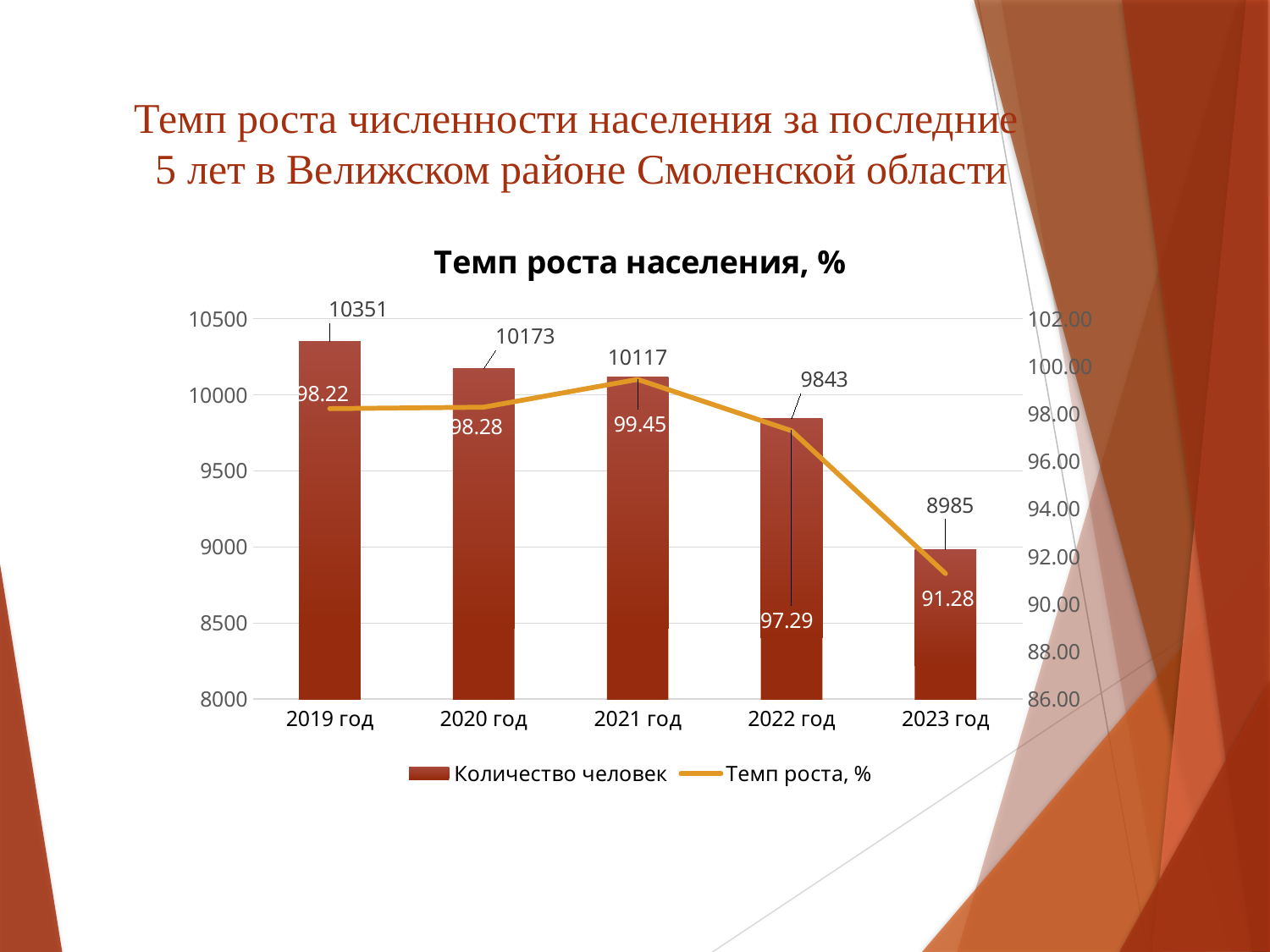
What is the difference in Количество человек between 2019 год and 2023 год? 1366 What is the value of Количество человек for 2019 год? 10351 Does Количество человек rise or fall from 2019 год to 2023 год? fall What is the value of Темп роста, % for 2023 год? 91.28 Is the value of Количество человек for 2022 год greater or less than 10000? less How many years are shown on the x axis? 5 What is the value of Темп роста, % for 2021 год? 99.45 Which year has the lowest Количество человек? 2023 год What kind of chart is this? Combined bar and line chart Which year has the highest Темп роста, %? 2021 год Which is larger, Количество человек for 2020 год or for 2021 год? 2020 год How many series does the legend list? 2